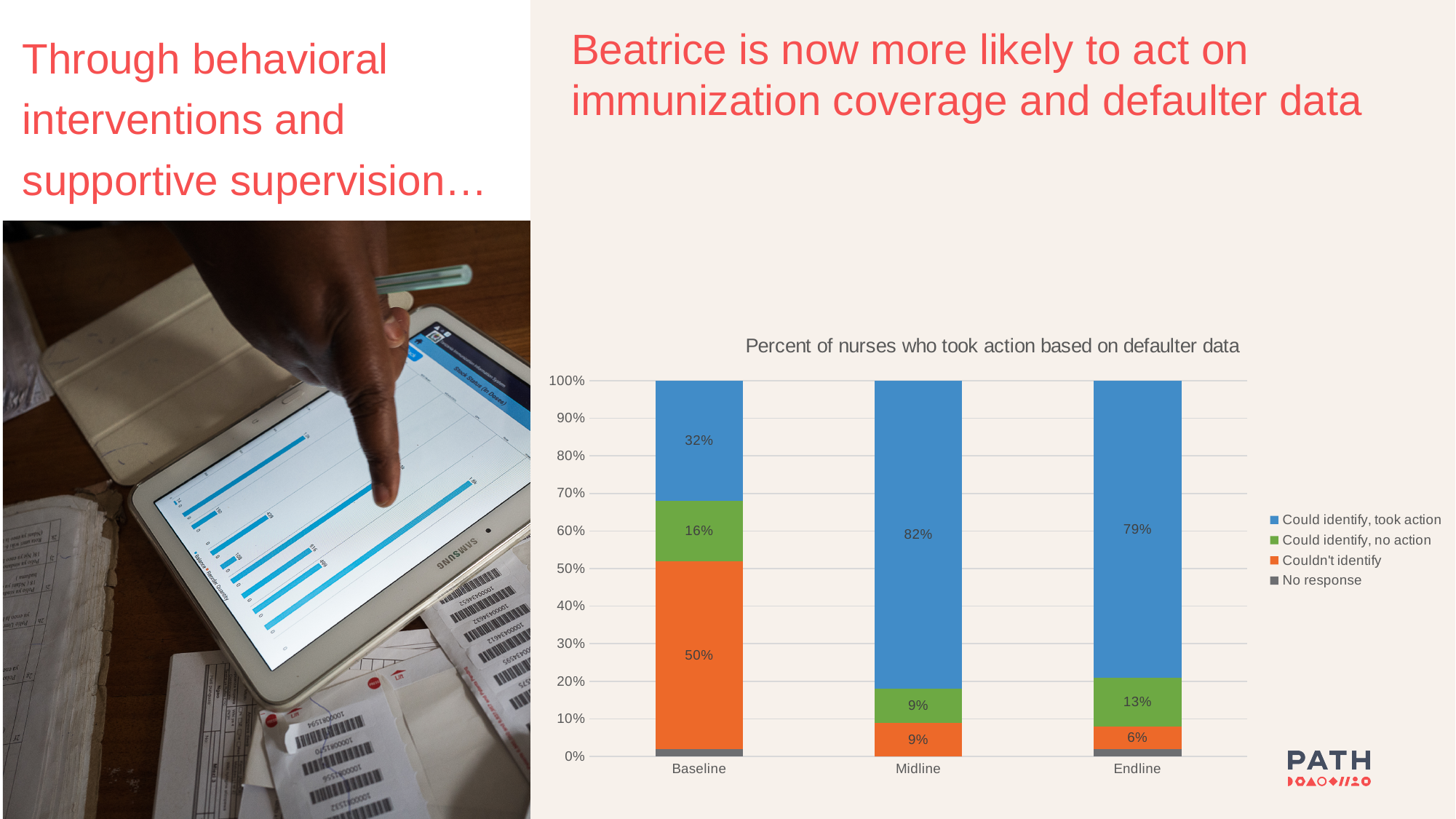
What percentage of nurses could identify and took action at Baseline? 32% What percentage of nurses couldn't identify at Baseline? 50% How many time points (categories) are shown on the x axis? 3 What type of chart is used to show the percent of nurses who took action based on defaulter data? Stacked bar chart By how many percentage points did the 'Could identify, took action' share increase from Baseline to Midline? 50 percentage points How many series does the legend list? 4 At which time point is the 'Couldn't identify' share lowest? Endline What percentage of nurses could identify and took action at Midline? 82% What percentage of nurses could identify but took no action at Endline? 13% What percentage of nurses couldn't identify at Endline? 6% Which is larger: the 'Could identify, no action' share at Baseline or at Midline? Baseline At which time point is the 'Could identify, took action' share highest? Midline